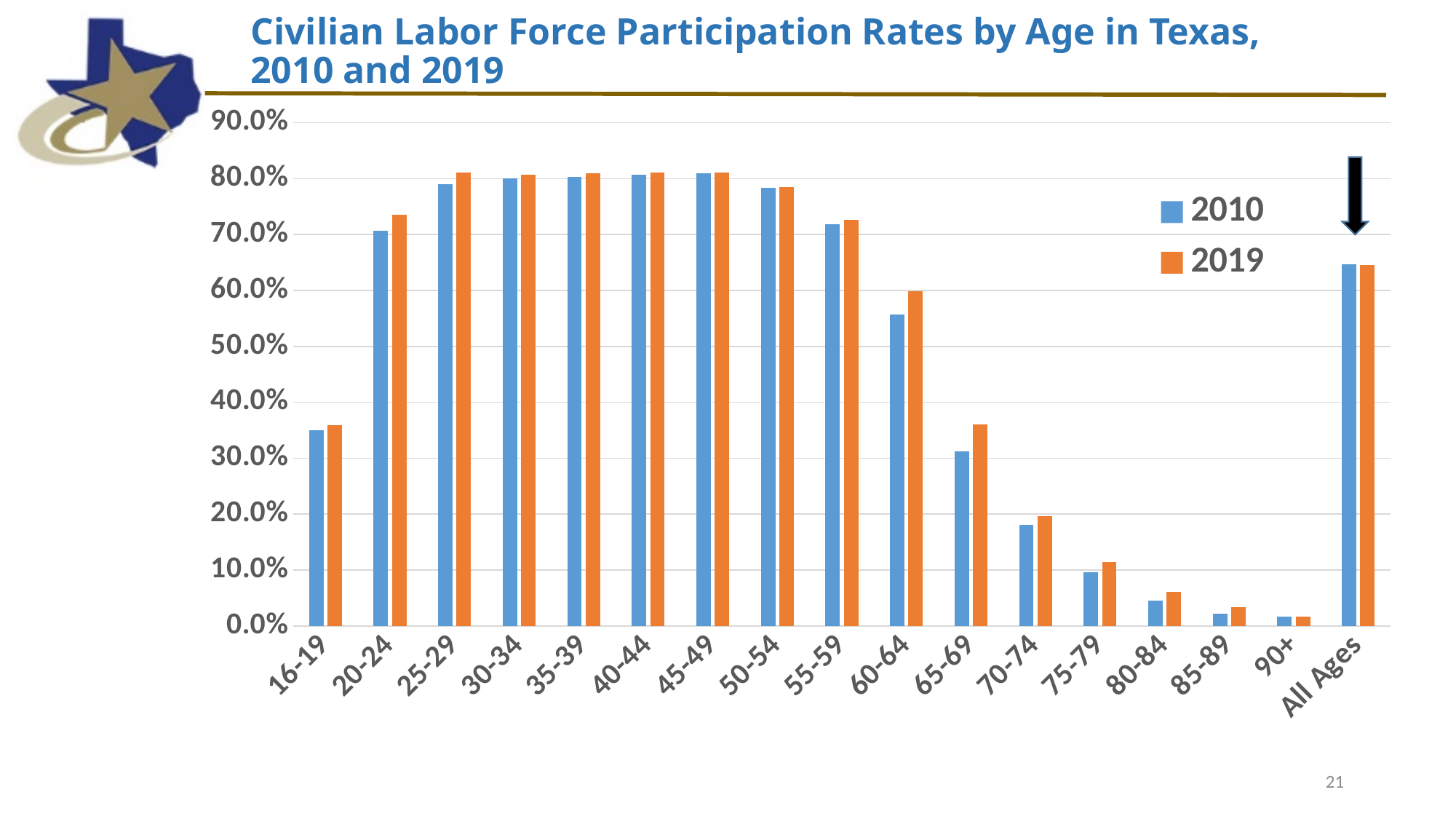
In 2010, which age group has the higher participation rate, 16-19 or 20-24? 20-24 Is the 2010 value for 60-64 greater or less than 50.0%? greater Is the 2010 value for 16-19 greater or less than 30.0%? greater Which colour represents the 2019 series? orange How many series does the legend list? 2 What kind of chart is shown on the slide? bar chart How many age categories are shown on the x axis, including All Ages? 17 Do the 2019 values rise or fall along the x axis from 45-49 to 90+? fall For the 65-69 age group, which year has the higher participation rate, 2010 or 2019? 2019 Which age group has the lowest participation rate in 2019? 90+ Is the 2010 value for 70-74 greater or less than 20.0%? less